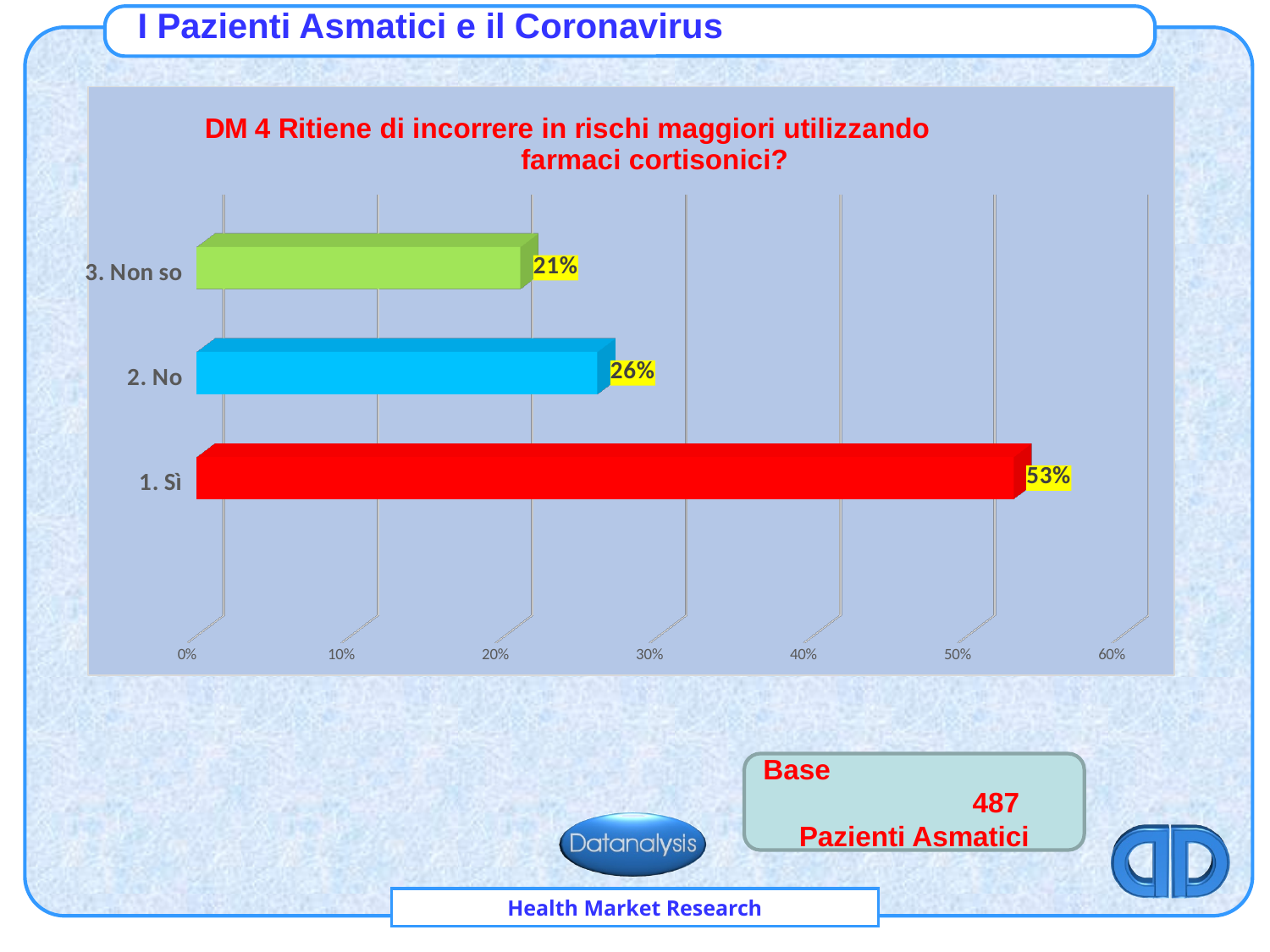
Which category has the lowest value? 3. Non so What is the value for "1. Sì"? 53% What is the difference between the values for "1. Sì" and "2. No"? 27% Which category has the highest value? 1. Sì What is the value for "2. No"? 26% What is the value for "3. Non so"? 21% What is the difference between the values for "2. No" and "3. Non so"? 5% How many categories are shown in the chart? 3 Which is larger, the value for "2. No" or the value for "3. Non so"? 2. No What kind of chart is shown on the slide? bar chart Is the value for "1. Sì" greater or less than 50%? greater What is the title of the chart? DM 4 Ritiene di incorrere in rischi maggiori utilizzando farmaci cortisonici?